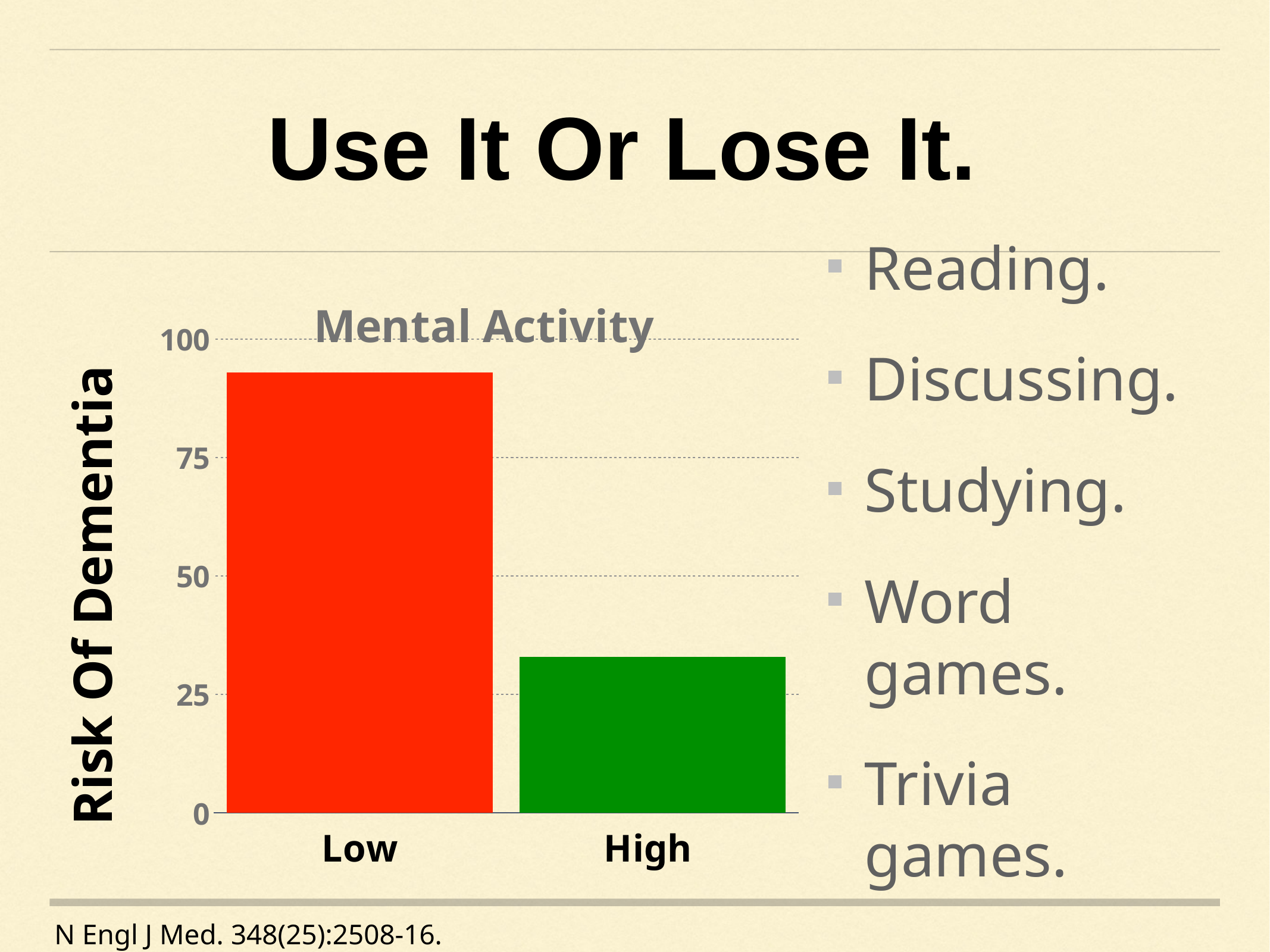
Is the value for High mental activity greater or less than 50? less Which category has the lowest risk of dementia in the chart? High Which has a larger value in the chart, Low or High mental activity? Low Which category has the highest risk of dementia in the chart? Low How many categories are shown on the x axis of the chart? 2 Is the value for High mental activity greater or less than 25? greater Do the values rise or fall from Low to High along the x axis? fall What is the title of the chart? Mental Activity What kind of chart is shown on the slide? bar chart Is the value for Low mental activity greater or less than 100? less What is the label on the vertical axis of the chart? Risk Of Dementia